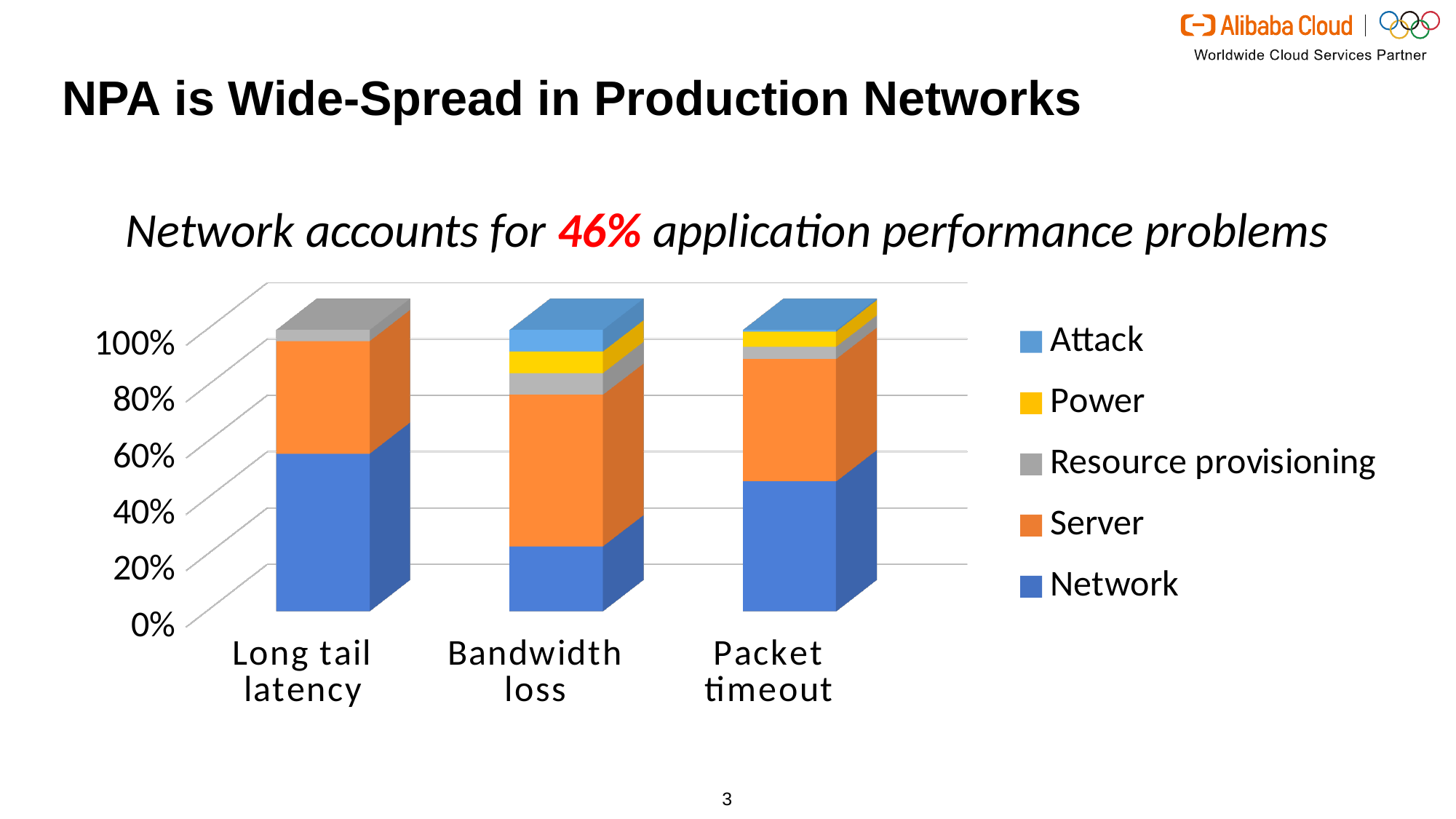
Which series is shown in blue at the bottom of each bar? Network How many categories are shown on the x axis of the chart? 3 What kind of chart is shown on the slide? stacked bar chart Which category has a larger Server segment, Long tail latency or Bandwidth loss? Bandwidth loss Is the Network share for Long tail latency greater or less than 40%? greater Which category has a larger Network segment, Packet timeout or Bandwidth loss? Packet timeout Is the Network share for Packet timeout greater or less than 20%? greater Which category has the largest Network segment? Long tail latency Is the Network share for Bandwidth loss greater or less than 40%? less Which category has the smallest Network segment? Bandwidth loss According to the text above the chart, what percentage of application performance problems does the network account for? 46% How many series does the chart's legend list? 5